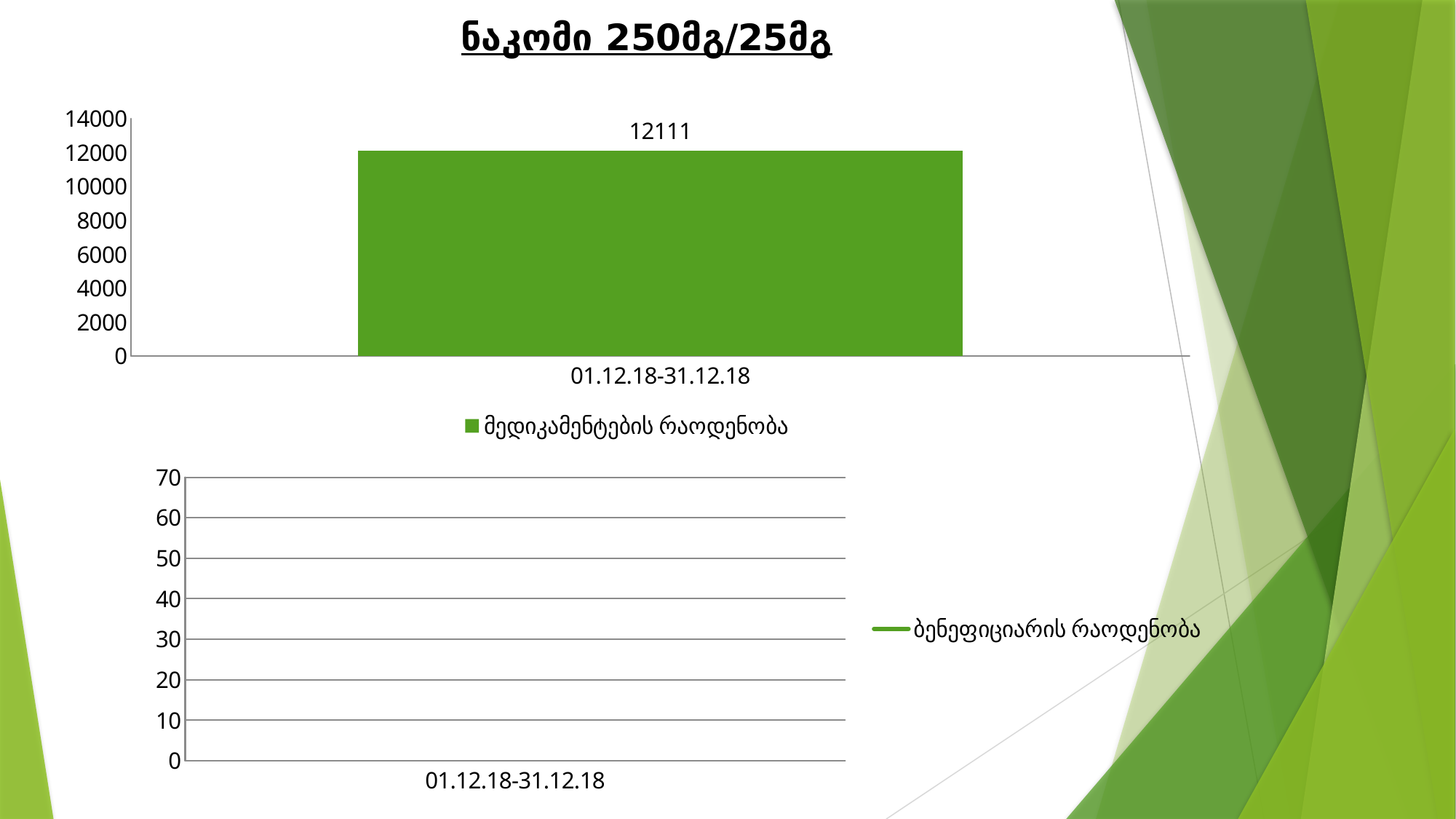
What kind of chart is the top chart? bar chart In the top chart, is the value for 01.12.18-31.12.18 greater or less than 12000? greater What is the legend entry of the top chart? მედიკამენტების რაოდენობა What is the highest tick value on the y axis of the bottom chart? 70 How many categories are shown on the x axis of the top chart? 1 How many series does the legend of the top chart list? 1 What is the title shown above the top chart? ნაკომი 250მგ/25მგ How many categories are shown on the x axis of the bottom chart? 1 In the top chart, is the value for 01.12.18-31.12.18 greater or less than 14000? less In the top chart, what is the value for 01.12.18-31.12.18? 12111 How many series does the legend of the bottom chart list? 1 What is the highest tick value on the y axis of the top chart? 14000